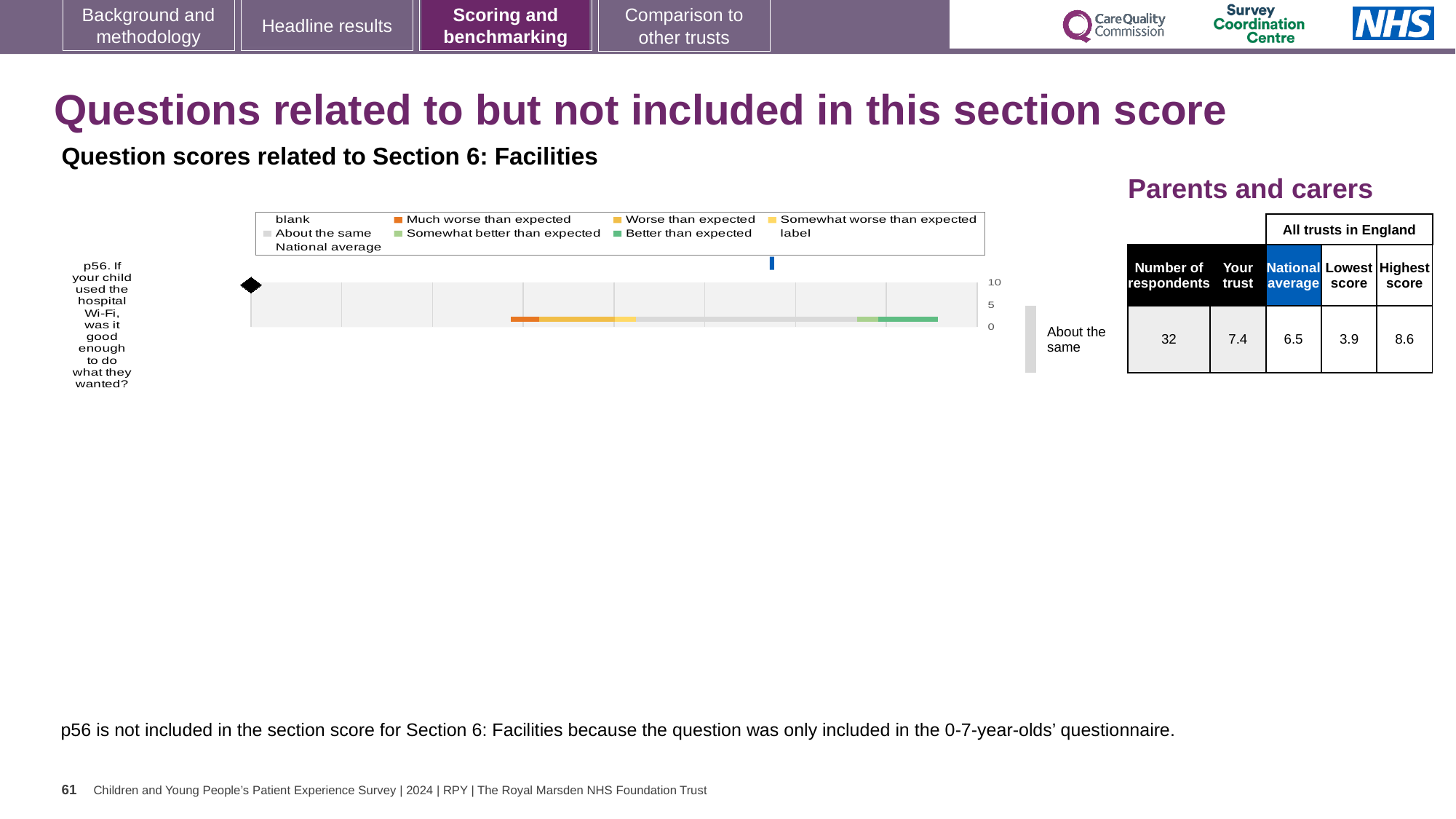
What is the Lowest score among all trusts in England for p56? 3.9 What is the difference between the Highest score and the Lowest score for p56? 4.7 What benchmark category label is shown beside the chart for p56? About the same Which is larger for p56: the Your trust score or the National average? Your trust How many respondents answered p56? 32 What is the Highest score among all trusts in England for p56? 8.6 What is the National average score for p56? 6.5 What is the 'Your trust' score for p56 shown in the table next to the chart? 7.4 How many questions are plotted on the chart? 1 What kind of chart is used to show the p56 question score? bar chart By how much does the Your trust score exceed the National average for p56? 0.9 Which respondent group does the chart and table relate to? Parents and carers